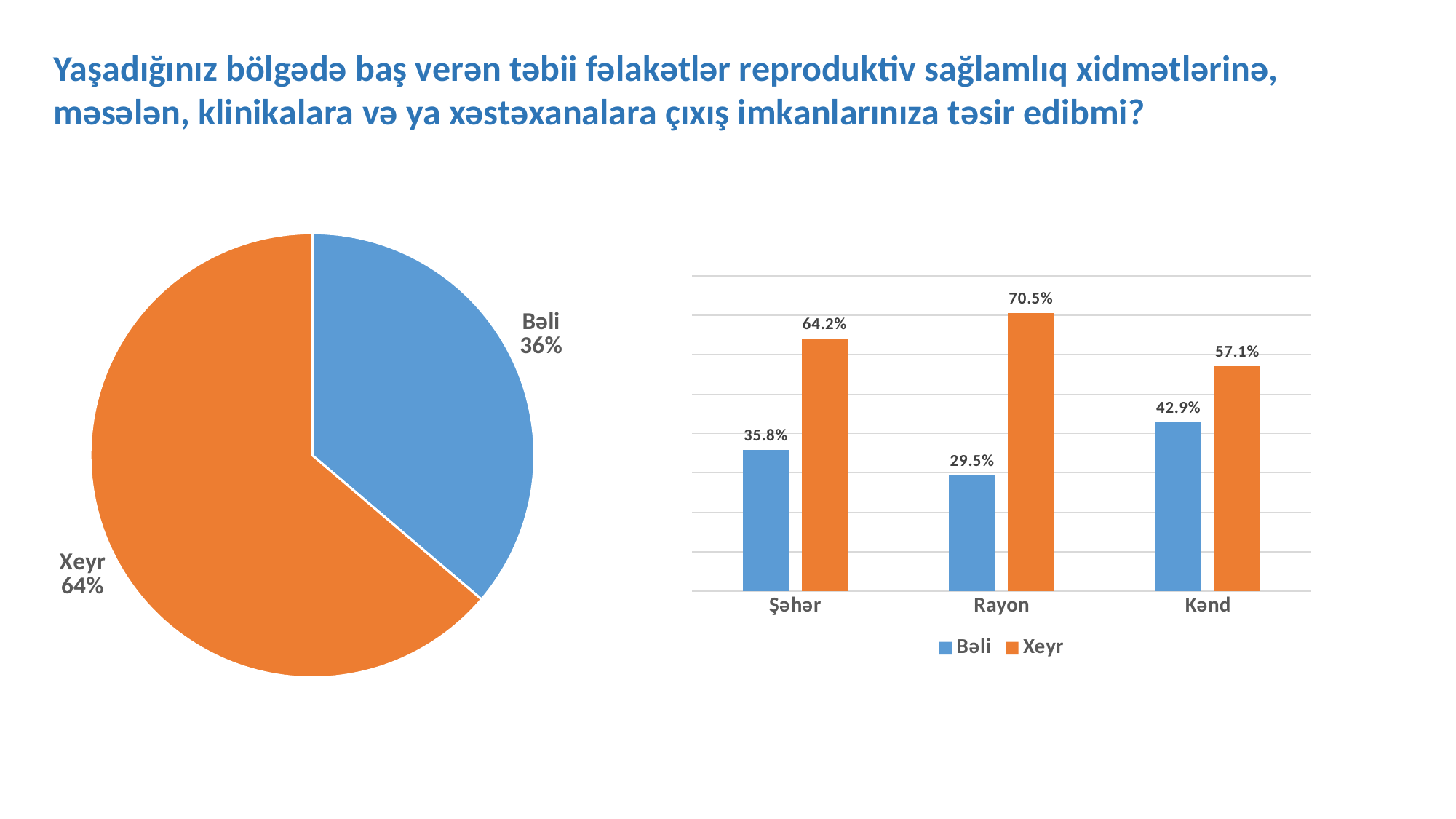
How many series does the legend of the bar chart on the right list? 2 In the bar chart on the right, what is the Xeyr value for Rayon? 70.5% What kind of chart is shown on the right of the slide? Bar chart In the pie chart on the left, which slice is larger, Bəli or Xeyr? Xeyr In the pie chart on the left, what share is labelled for Bəli? 36% In the bar chart on the right, which category has the lowest Bəli value? Rayon In the bar chart on the right, what is the Bəli value for Kənd? 42.9% In the pie chart on the left, what share is labelled for Xeyr? 64% In the bar chart on the right, what is the Bəli value for Şəhər? 35.8% In the bar chart on the right, what is the difference between the Xeyr and Bəli values for Kənd? 14.2% What kind of chart is shown on the left of the slide? Pie chart In the bar chart on the right, which category has the highest Xeyr value? Rayon